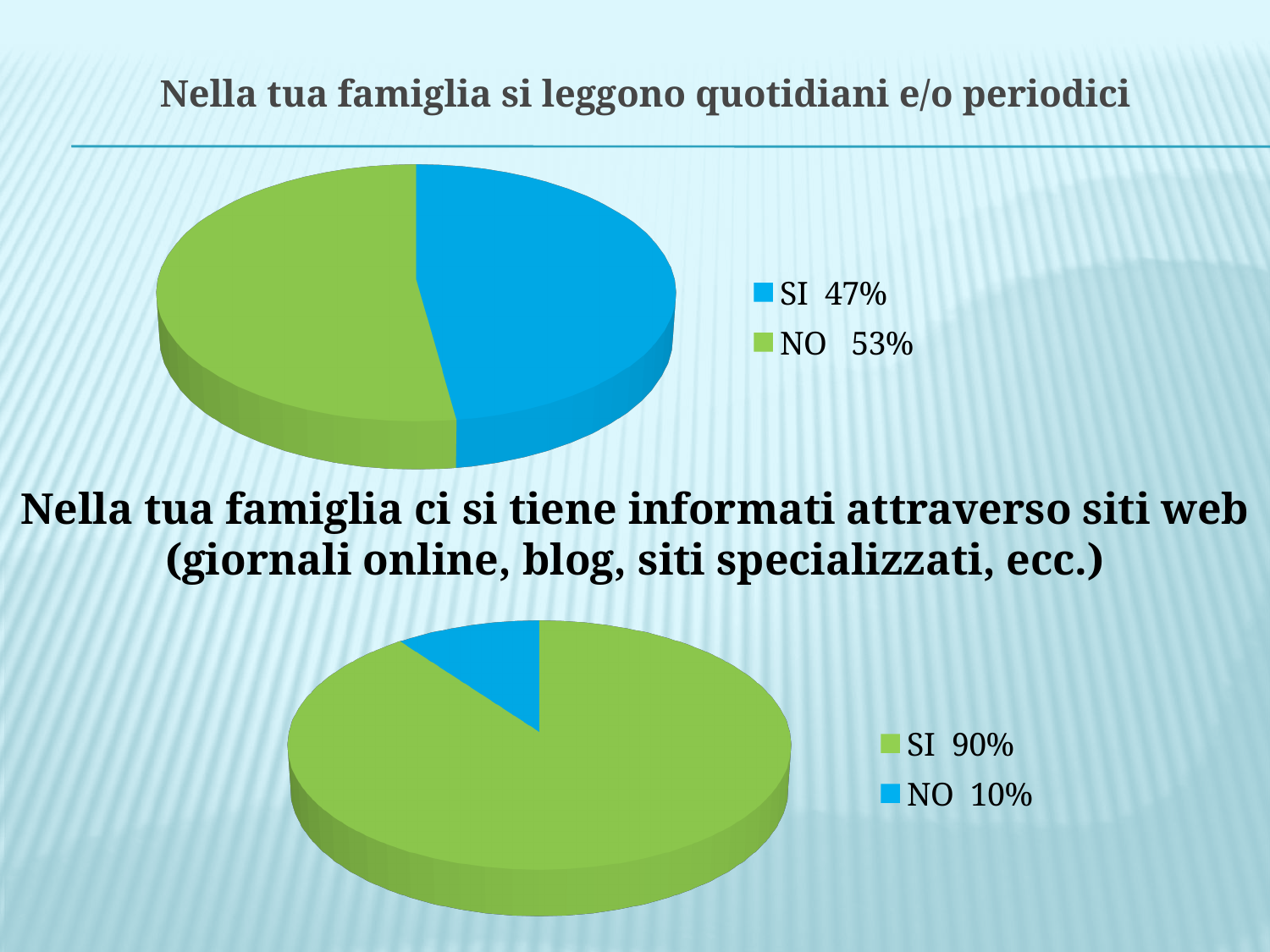
In the bottom pie chart ("Nella tua famiglia ci si tiene informati attraverso siti web"), what percentage is shown for NO? 10% In the top pie chart ("Nella tua famiglia si leggono quotidiani e/o periodici"), what percentage is shown for SI? 47% In the top pie chart, what is the difference in percentage points between NO and SI? 6 In the top pie chart, what colour represents SI? Blue In the top pie chart, which category has the larger share, SI or NO? NO In the top pie chart ("Nella tua famiglia si leggono quotidiani e/o periodici"), what percentage is shown for NO? 53% In the bottom pie chart, what is the difference in percentage points between SI and NO? 80 In the bottom pie chart ("Nella tua famiglia ci si tiene informati attraverso siti web"), what percentage is shown for SI? 90% In the bottom pie chart, which category has the smallest share? NO What type of chart is used for the top chart on the slide? Pie chart In the bottom pie chart, what colour represents SI? Green How many categories does the legend of the bottom pie chart list? 2